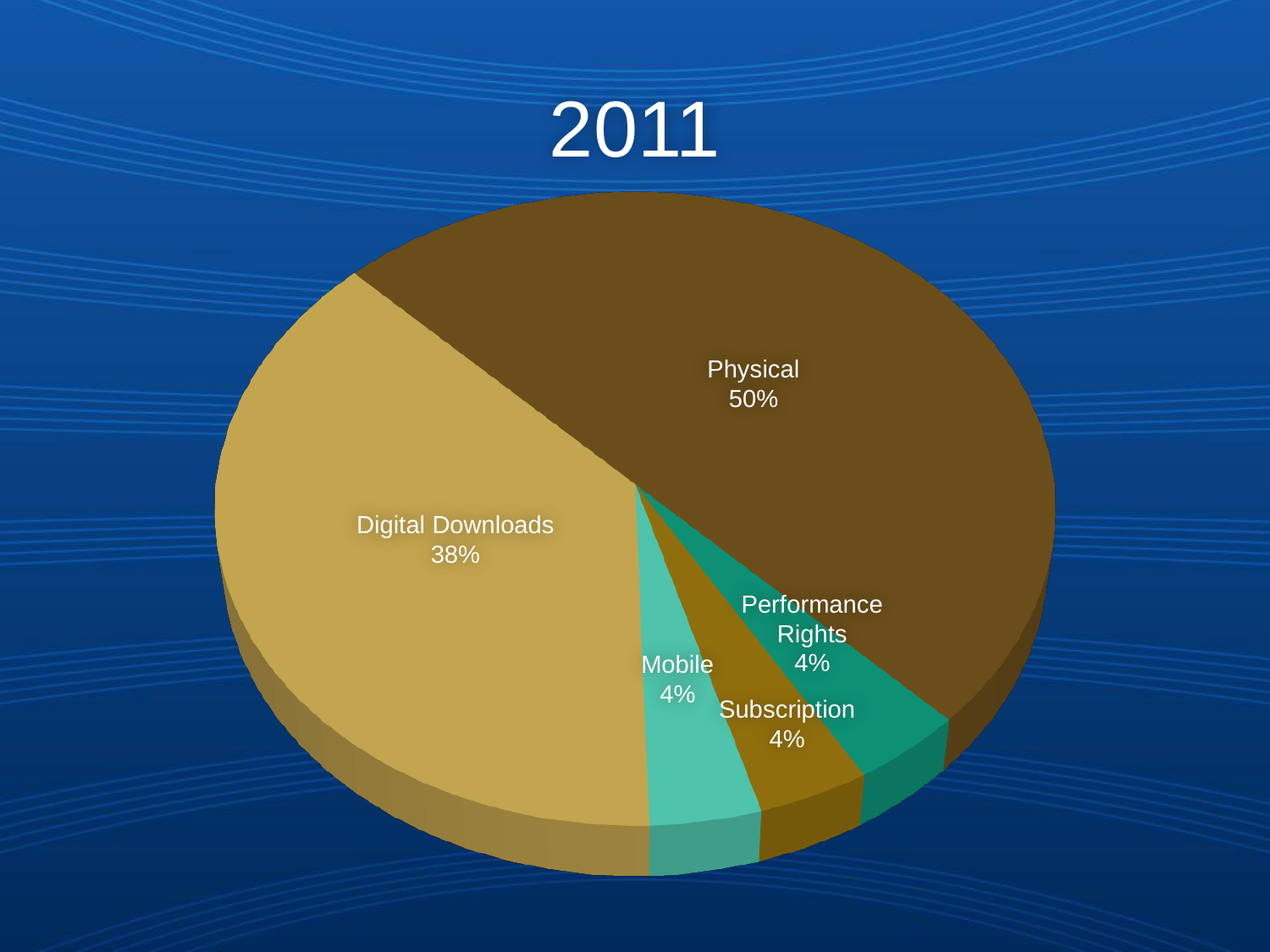
Which is larger, Digital Downloads or Physical? Physical What is the combined share of Mobile, Subscription and Performance Rights? 12% How many slices does the pie chart have? 5 What kind of chart is shown on the slide? Pie chart What is the difference in percentage points between Physical and Digital Downloads? 12 What is the title of the chart? 2011 What share of the pie does Subscription account for? 4% What share of the pie does Mobile account for? 4% What share of the pie does Digital Downloads account for? 38% Which category has the largest slice of the pie? Physical What share of the pie does Performance Rights account for? 4% What share of the pie does Physical account for? 50%